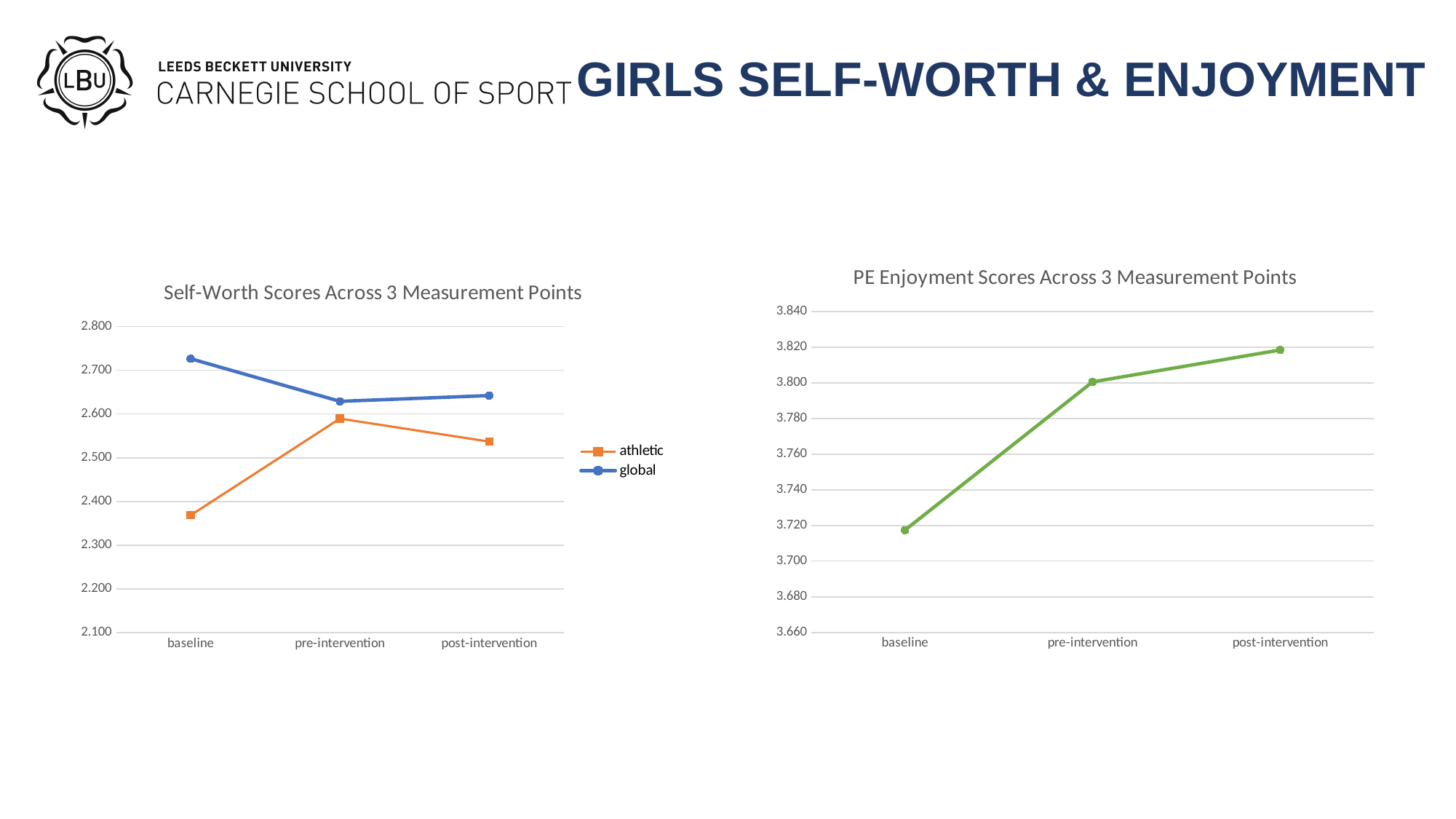
In the 'PE Enjoyment Scores Across 3 Measurement Points' chart, do the values rise or fall from baseline to post-intervention? rise In the 'Self-Worth Scores Across 3 Measurement Points' chart, which colour is the athletic series line? orange In the 'Self-Worth Scores Across 3 Measurement Points' chart, how many measurement points are shown on the x axis? 3 How many series does the legend of the 'Self-Worth Scores Across 3 Measurement Points' chart list? 2 In the 'Self-Worth Scores Across 3 Measurement Points' chart, is the athletic value at baseline greater or less than 2.400? less In the 'PE Enjoyment Scores Across 3 Measurement Points' chart, is the value at post-intervention greater or less than 3.800? greater In the 'Self-Worth Scores Across 3 Measurement Points' chart, which series has the larger value at baseline, athletic or global? global What type of chart is the 'Self-Worth Scores Across 3 Measurement Points' chart? line chart In the 'Self-Worth Scores Across 3 Measurement Points' chart, at which measurement point is the global series highest? baseline In the 'Self-Worth Scores Across 3 Measurement Points' chart, at which measurement point is the athletic series lowest? baseline In the 'Self-Worth Scores Across 3 Measurement Points' chart, is the global value at baseline greater or less than 2.700? greater In the 'PE Enjoyment Scores Across 3 Measurement Points' chart, at which measurement point is the value lowest? baseline